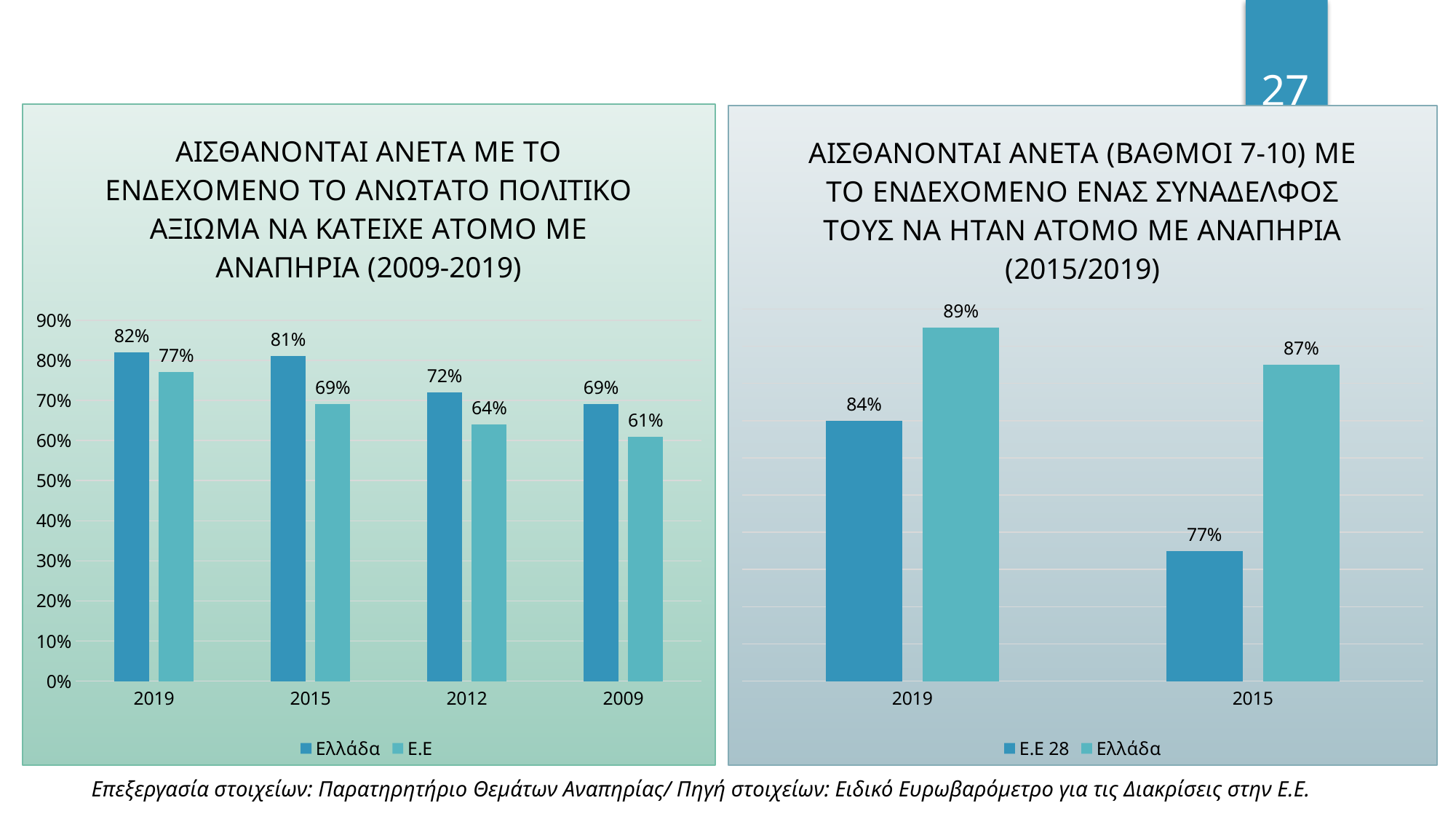
In the right chart, what is the difference between Ελλάδα and Ε.Ε 28 in 2019? 5% In the right chart, which is larger in 2015: Ε.Ε 28 or Ελλάδα? Ελλάδα In the left chart, what is the value for Ε.Ε in 2012? 64% In the left chart, what is the difference between Ελλάδα and Ε.Ε in 2015? 12% In the left chart, which year has the lowest value for Ε.Ε? 2009 In the right chart, what is the value for Ελλάδα in 2019? 89% In the right chart, what is the value for Ε.Ε 28 in 2015? 77% In the left chart, do the Ελλάδα values rise or fall from 2019 to 2009 along the x axis? fall What kind of chart is the right chart? bar chart In the left chart, what is the value for Ελλάδα in 2019? 82% In the left chart, how many years are shown on the x axis? 4 In the left chart, how many series does the legend list? 2